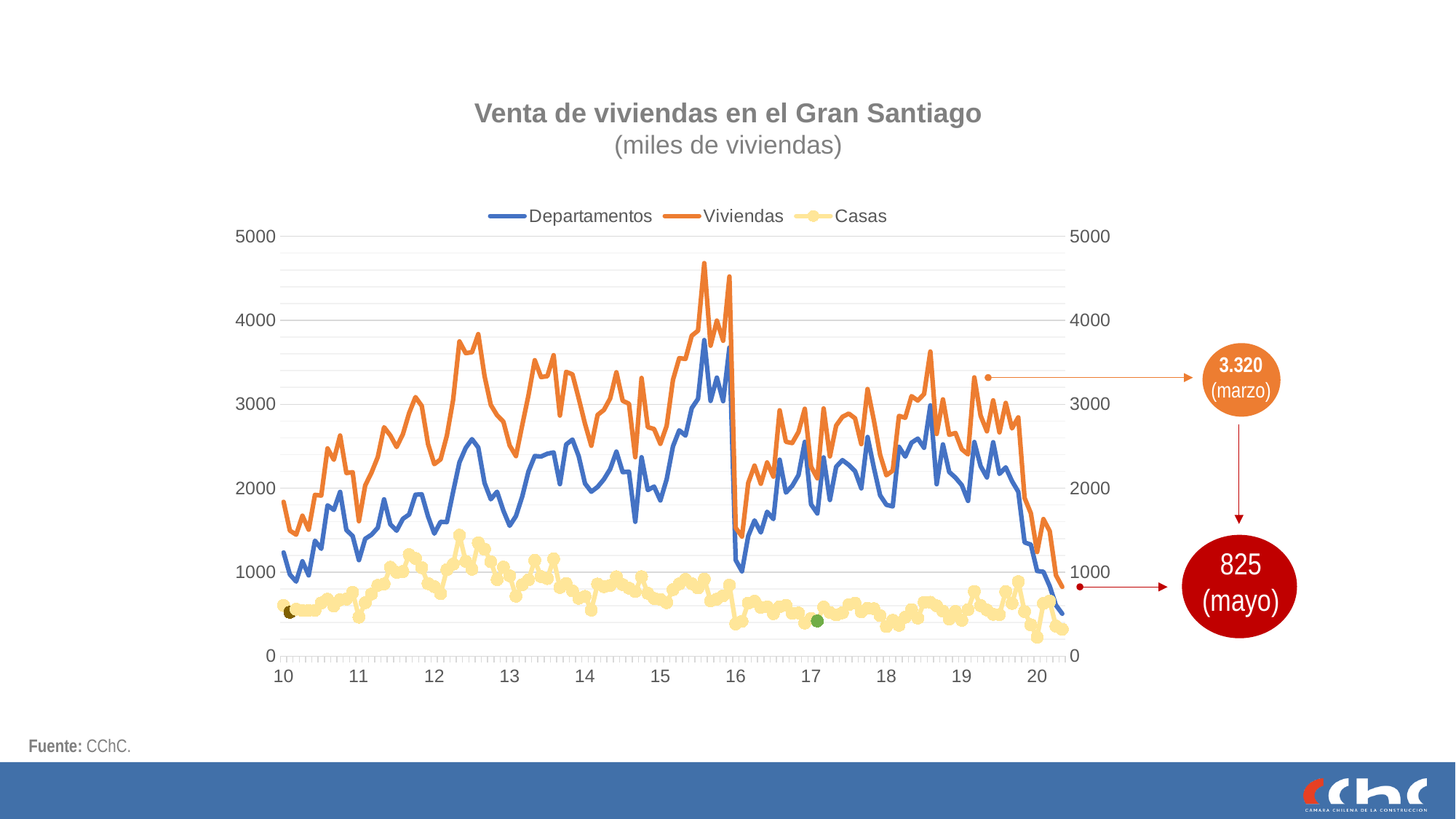
What is the difference between the annotated marzo value (3.320) and the annotated mayo value (825)? 2.495 How many series does the legend list? 3 Which series has the lowest values across the whole chart? Casas Is the highest point of the Departamentos series greater or less than 3000? greater Does the Viviendas series rise or fall between the x-axis labels 19 and 20? fall What kind of chart is shown on the slide? line chart What is the title of the chart? Venta de viviendas en el Gran Santiago (miles de viviendas) What are the three series named in the legend? Departamentos, Viviendas, Casas Which series has the highest values across the whole chart? Viviendas Is the value of the Viviendas series at the x-axis label 20 greater or less than 2000? less What value is annotated for mayo on the chart? 825 What value is annotated for marzo on the chart? 3.320